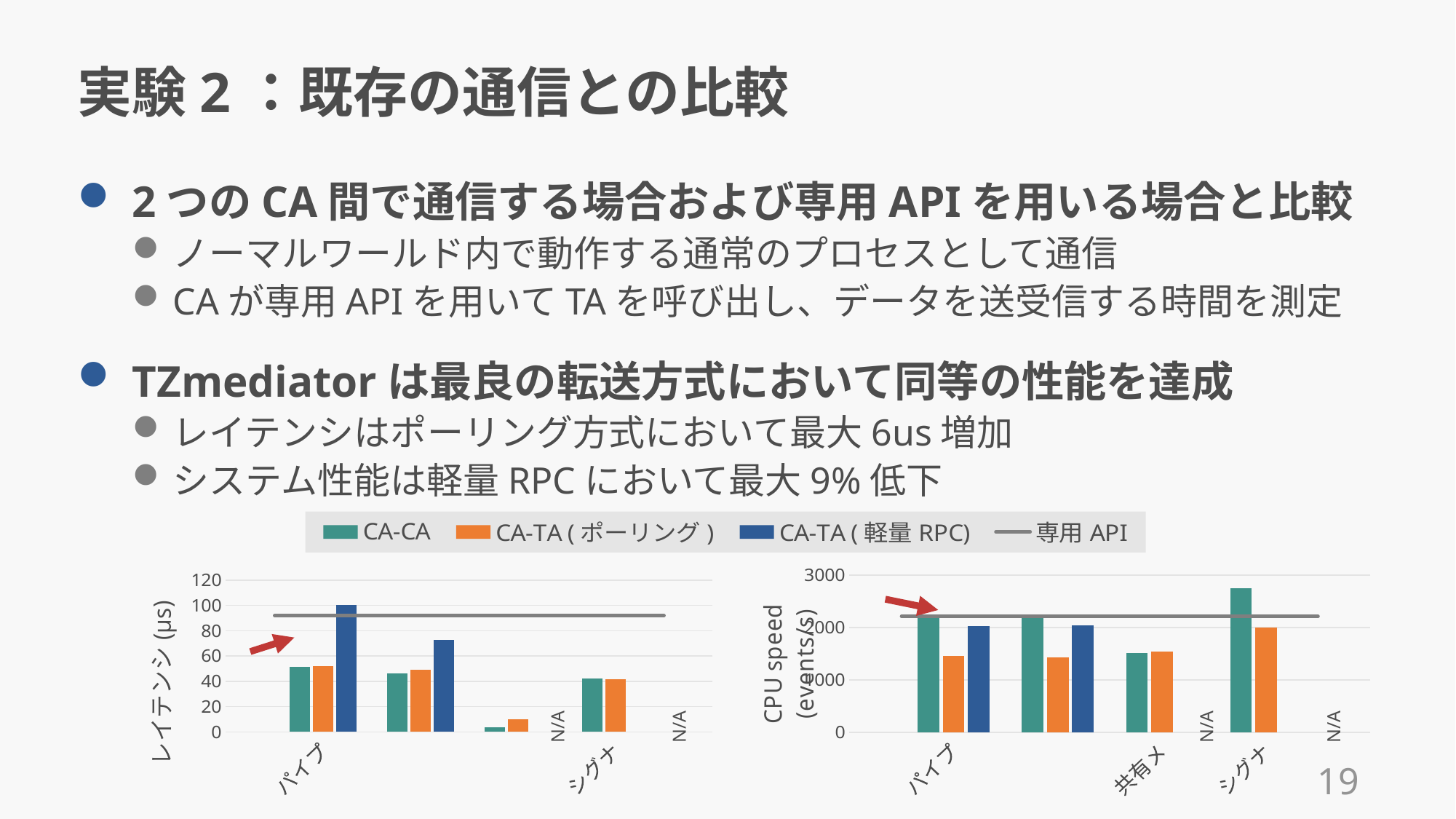
In the right chart (CPU speed), which is larger for シグナ: CA-CA or CA-TA (ポーリング)? CA-CA In the right chart (CPU speed), is the CA-CA value for シグナ greater or less than 2000? greater In the left chart (レイテンシ), is the CA-CA value for シグナ greater or less than 60? less Which legend entry is drawn as a horizontal line rather than bars? 専用 API How many series does the shared legend list? 4 In the left chart (レイテンシ), is the CA-TA (軽量 RPC) value for パイプ greater or less than 80? greater What kind of chart is the left chart (レイテンシ)? bar chart In the left chart (レイテンシ), which is larger for パイプ: CA-CA or CA-TA (軽量 RPC)? CA-TA (軽量 RPC) In the right chart (CPU speed), which labelled category has the highest CA-CA bar? シグナ